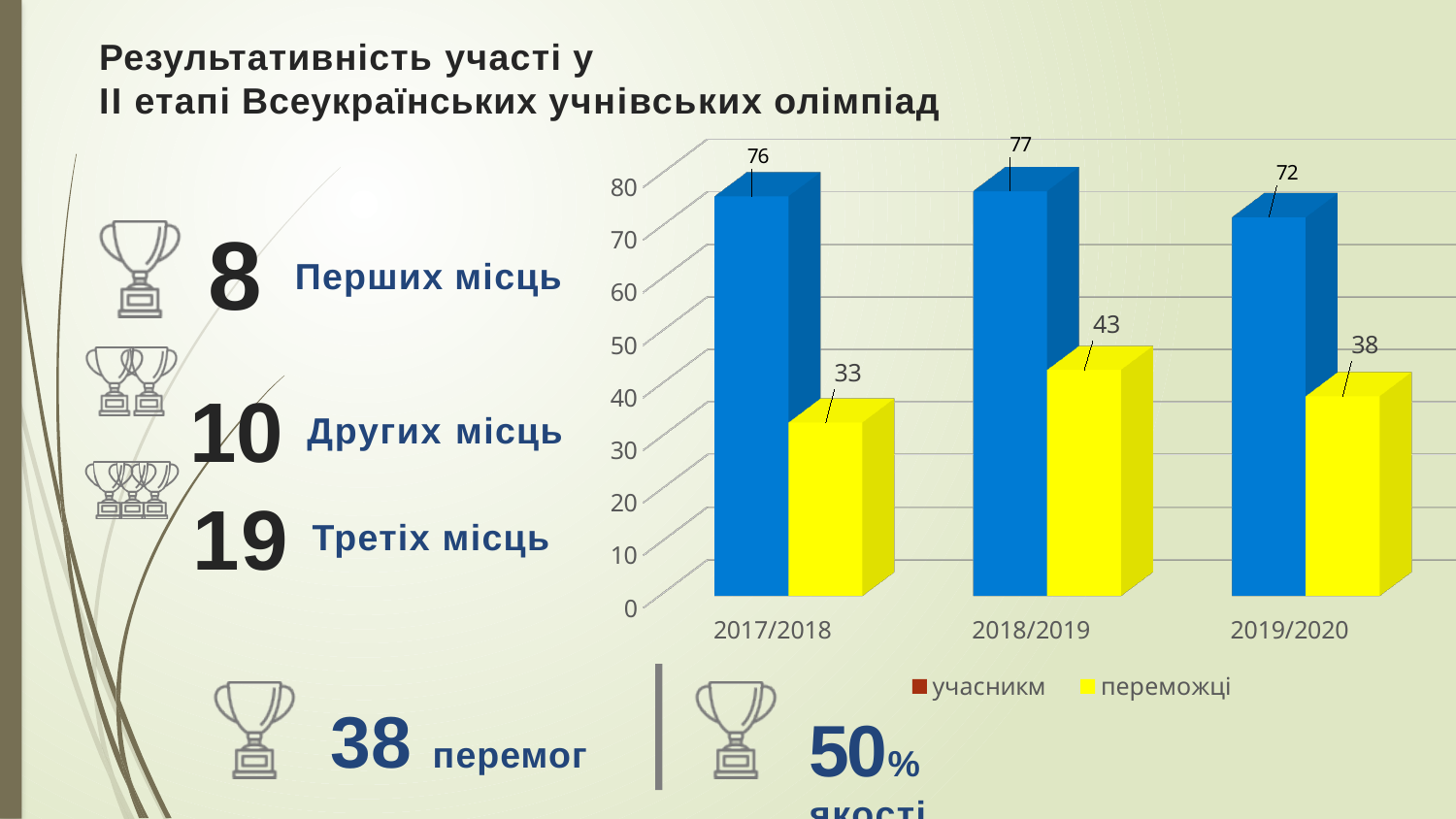
How many year categories are shown on the x axis? 3 Which is larger: переможці in 2018/2019 or переможці in 2019/2020? переможці in 2018/2019 Does the value for переможці rise or fall from 2017/2018 to 2018/2019? rise In which year is the value for учасникм the highest? 2018/2019 What is the difference between the переможці values for 2018/2019 and 2019/2020? 5 What is the value for учасникм in 2019/2020? 72 What is the value for переможці in 2018/2019? 43 What kind of chart is shown on the slide? bar chart How many series does the legend list? 2 In which year is the value for переможці the lowest? 2017/2018 What is the value for переможці in 2017/2018? 33 What is the difference between учасникм and переможці in 2017/2018? 43